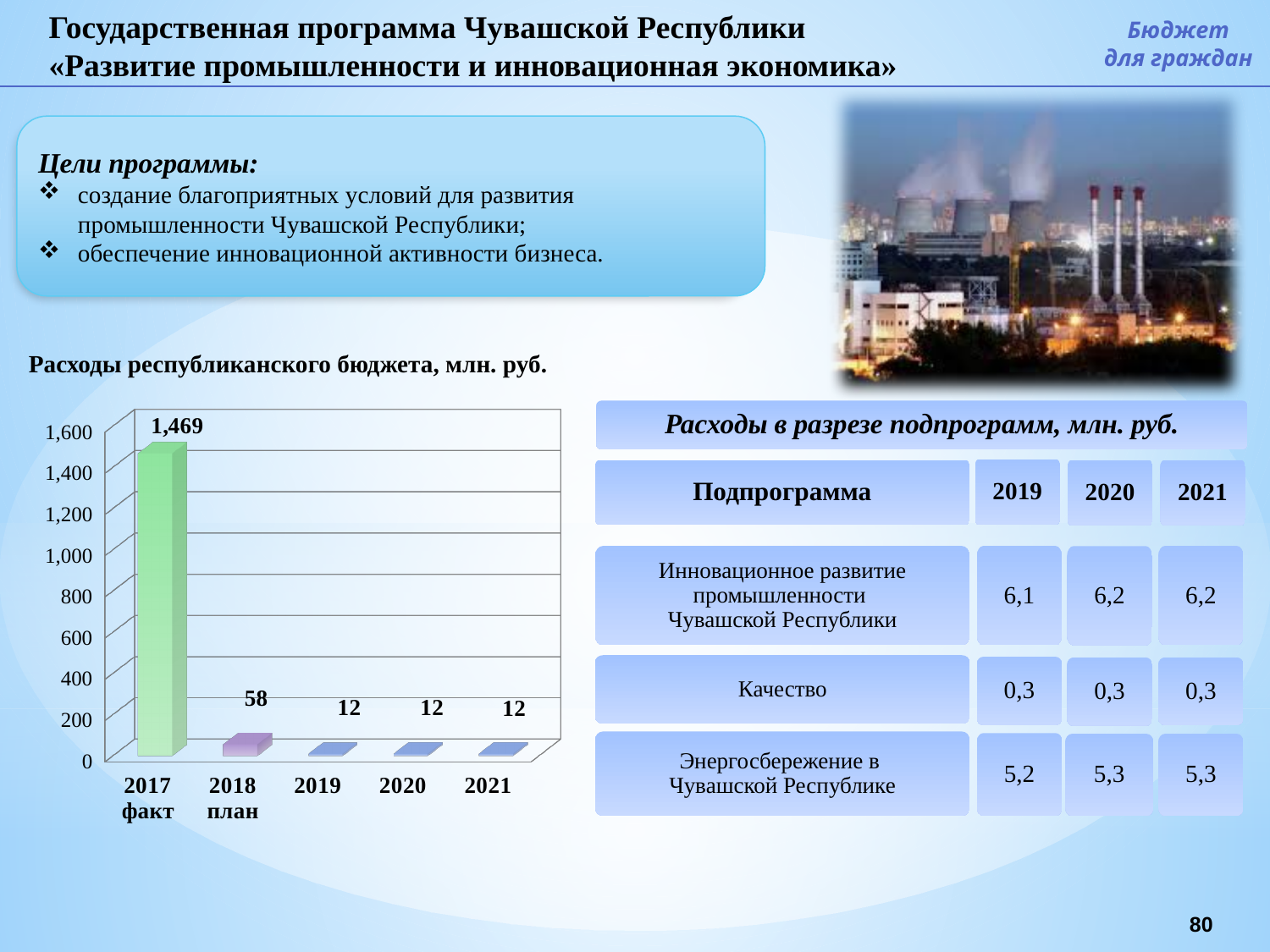
What kind of chart is shown on the slide? bar chart What is the difference between the values for 2017 факт and 2018 план? 1,411 What is the value for 2020 in the chart? 12 How many categories are shown on the x axis of the chart? 5 Is the value for 2017 факт greater or less than 1,400? greater Do the values in the chart rise or fall from 2017 факт to 2019? fall What is the title of the chart on the slide? Расходы республиканского бюджета, млн. руб. What is the value for 2017 факт in the chart 'Расходы республиканского бюджета, млн. руб.'? 1,469 What is the value for 2018 план in the chart? 58 What is the difference between the values for 2018 план and 2019? 46 Which is larger, the value for 2018 план or the value for 2021? 2018 план Which category has the highest value in the chart? 2017 факт